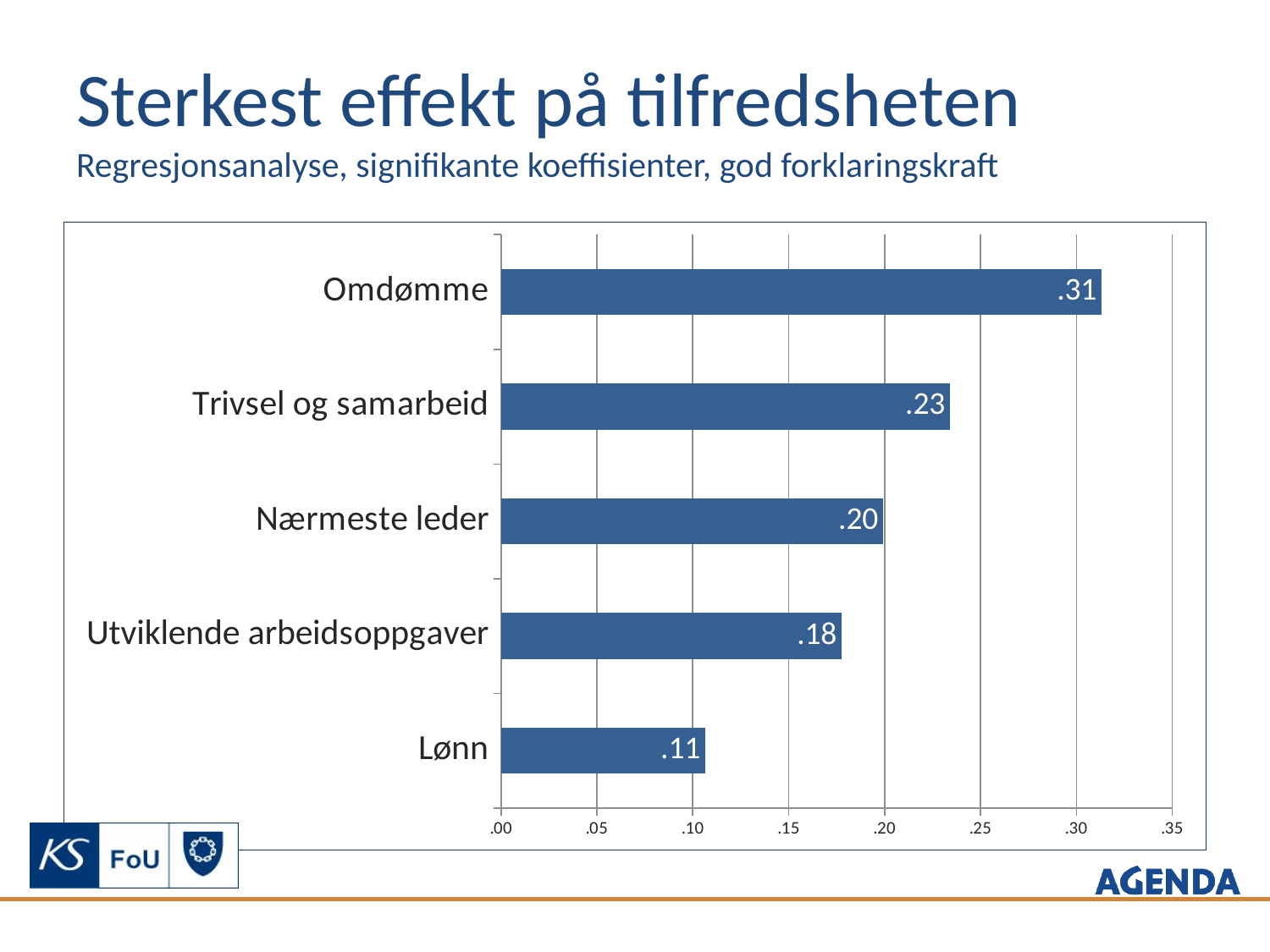
What is the value for Omdømme? .31 What is the title of the slide? Sterkest effekt på tilfredsheten Which category has the highest value? Omdømme What is the value for Nærmeste leder? .20 What is the value for Trivsel og samarbeid? .23 Which is larger, the value for Trivsel og samarbeid or the value for Nærmeste leder? Trivsel og samarbeid What is the value for Utviklende arbeidsoppgaver? .18 What is the difference between the values for Omdømme and Lønn? .20 What kind of chart is shown on the slide? Bar chart What is the value for Lønn? .11 How many categories are shown in the chart? 5 Which category has the lowest value? Lønn